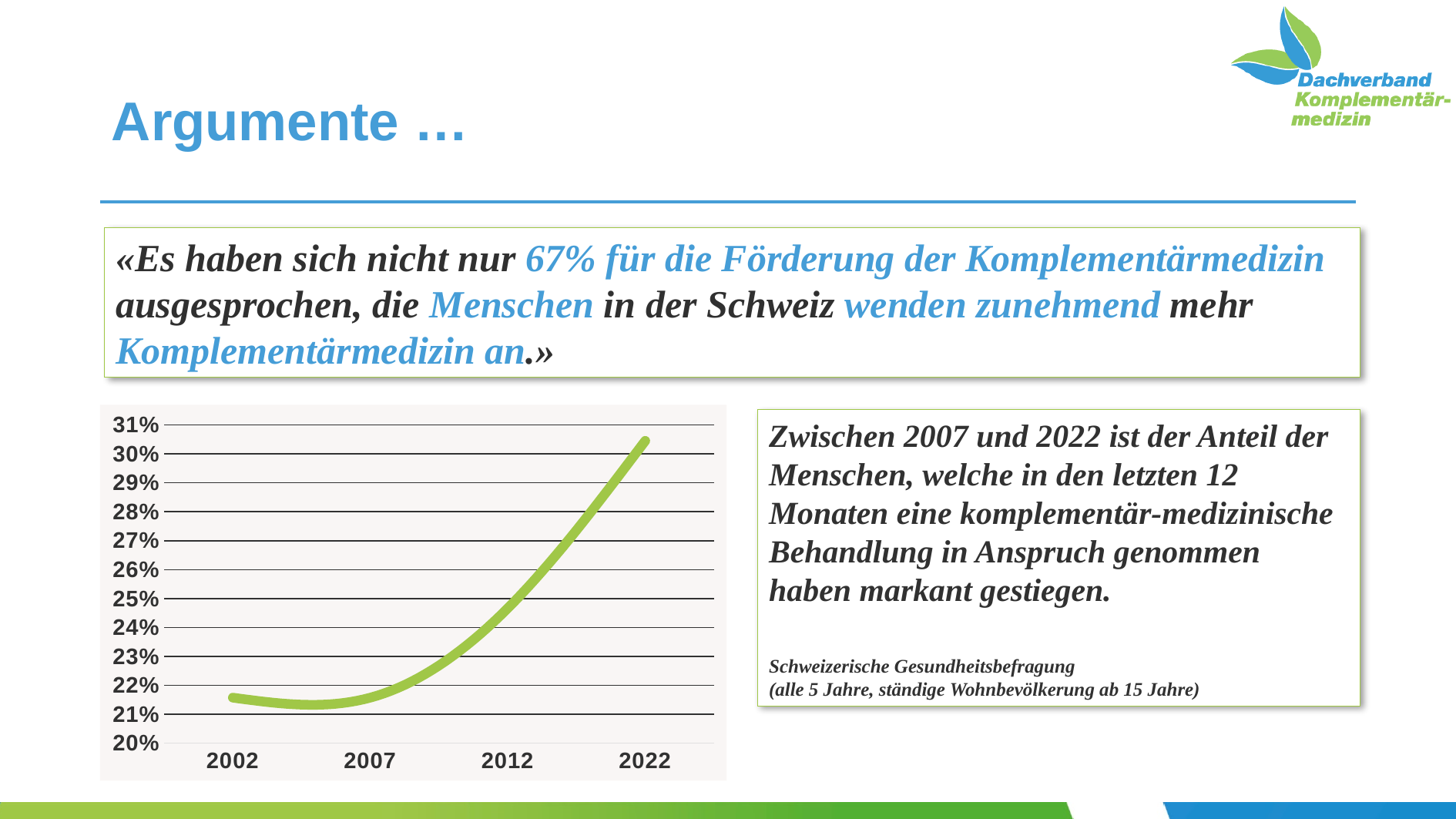
Is the value for 2002 greater or less than 23%? less Which is larger, the value for 2012 or the value for 2002? 2012 Is the value for 2012 greater or less than 23%? greater What kind of chart is shown on the slide? line chart How many years are shown on the x axis of the chart? 4 What colour is the line in the chart? green Is the value for 2012 greater or less than 28%? less Which year has the highest value in the chart? 2022 Which is larger, the value for 2022 or the value for 2012? 2022 Do the values in the chart rise or fall between 2007 and 2022? rise